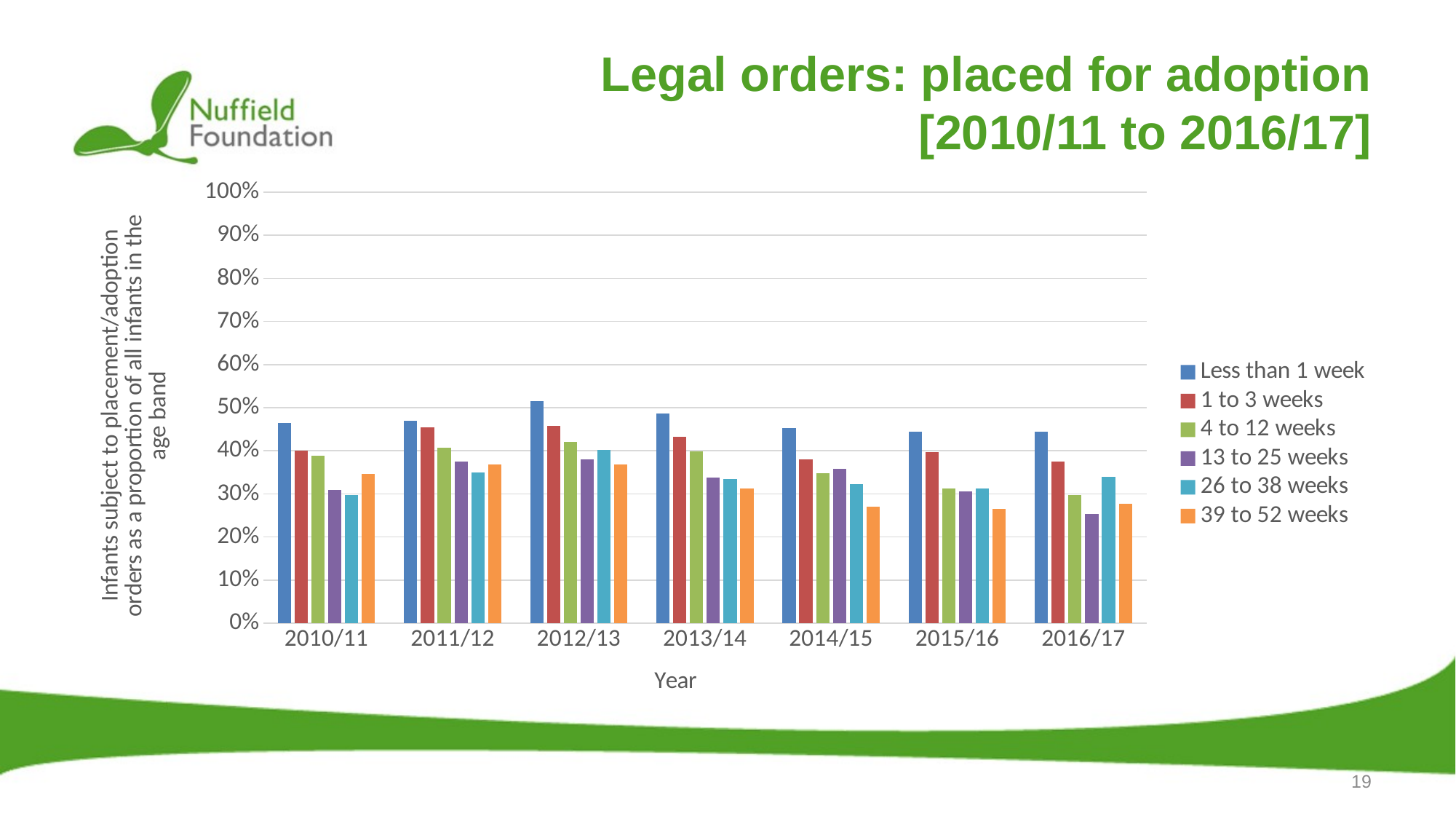
Is the value for 'Less than 1 week' in 2012/13 greater or less than 50%? greater Is the value for '1 to 3 weeks' in 2011/12 greater or less than 40%? greater How many series does the legend list? 6 Is the value for '13 to 25 weeks' in 2016/17 greater or less than 30%? less What kind of chart is shown on the slide? Bar chart In which year is the 'Less than 1 week' bar highest? 2012/13 In 2010/11, which is larger: 'Less than 1 week' or '39 to 52 weeks'? Less than 1 week What is the title of the x axis? Year Does the 'Less than 1 week' series rise or fall from 2012/13 to 2015/16? fall In 2016/17, which is larger: '26 to 38 weeks' or '13 to 25 weeks'? 26 to 38 weeks How many years are shown on the x axis? 7